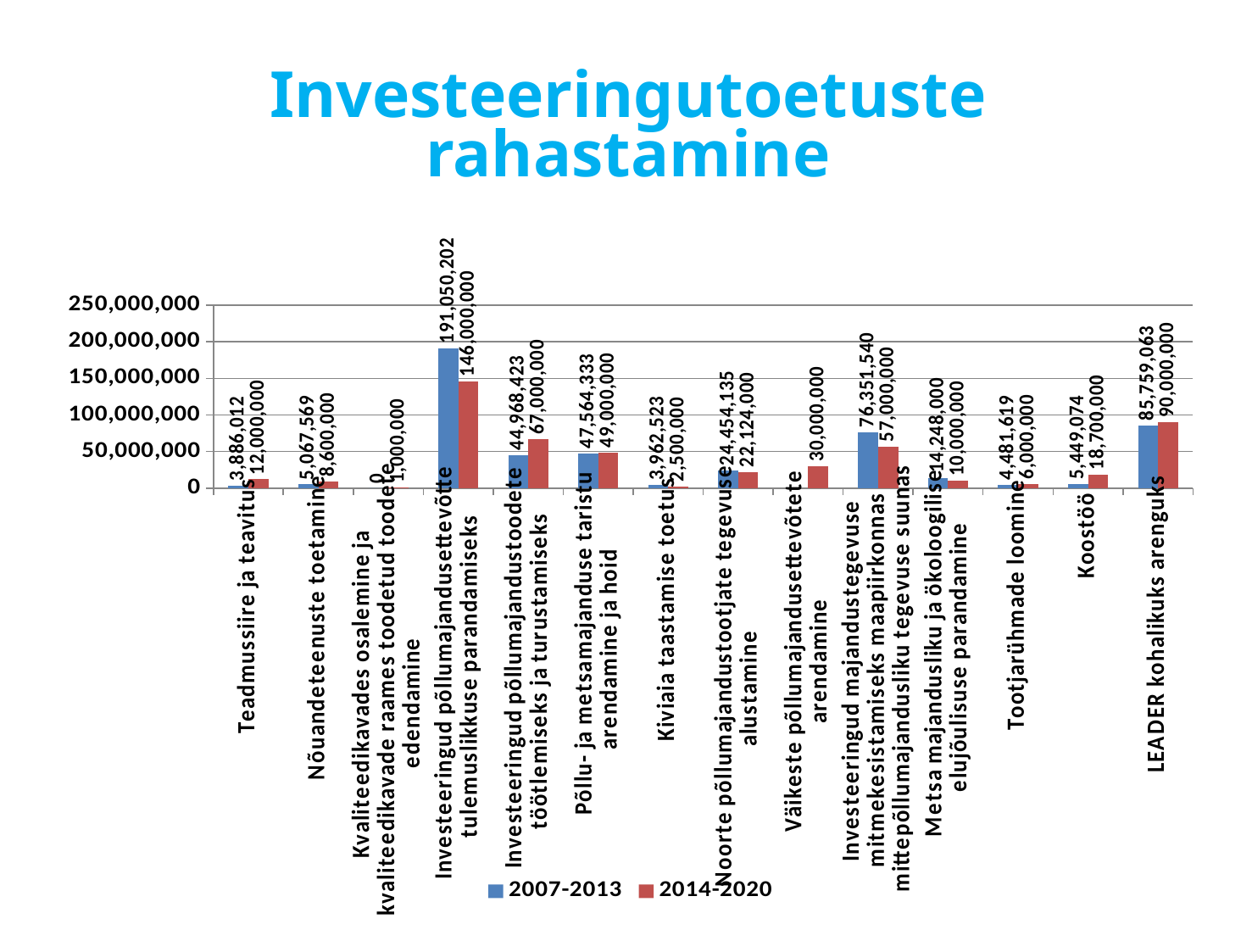
Is the 2007-2013 value for Investeeringud majandustegevuse mitmekesistamiseks maapiirkonnas mittepõllumajandusliku tegevuse suunas greater or less than 50,000,000? greater What is the title of the chart? Investeeringutoetuste rahastamine How many categories are shown on the x axis? 14 What is the 2007-2013 value for LEADER kohalikuks arenguks? 85,759,063 Which category has the highest 2014-2020 value? Investeeringud põllumajandusettevõtte tulemuslikkuse parandamiseks What is the difference between the 2007-2013 and 2014-2020 values for Teadmussiire ja teavitus? 8,113,988 What type of chart is shown on the slide? bar chart What is the 2014-2020 value for Koostöö? 18,700,000 How many series does the legend list? 2 For Investeeringud põllumajandustoodete töötlemiseks ja turustamiseks, which series has the larger value, 2007-2013 or 2014-2020? 2014-2020 What is the 2007-2013 value for Investeeringud põllumajandusettevõtte tulemuslikkuse parandamiseks? 191,050,202 Which category has the lowest 2014-2020 value? Kvaliteedikavades osalemine ja kvaliteedikavade raames toodetud toodete edendamine